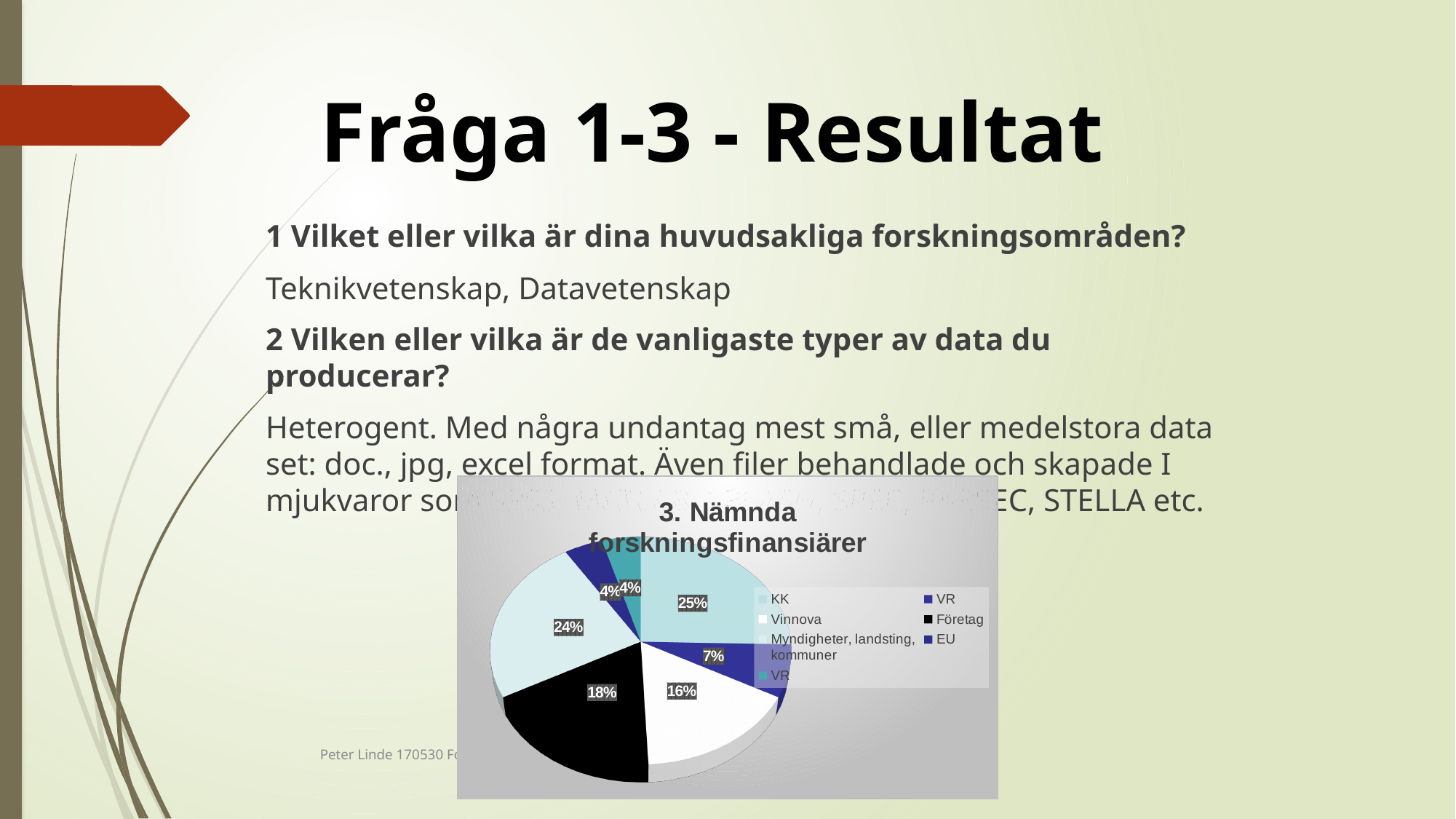
What share of the pie does KK have? 25% What share of the pie does Företag have? 18% What share of the pie does Vinnova have? 16% What is the difference in percentage points between Företag and Vinnova? 2% What share of the pie does EU have? 4% What share of the pie does Myndigheter, landsting, kommuner have? 24% Which is larger, the slice for KK or the slice for Företag? KK Which category has the largest slice of the pie? KK What is the title of the pie chart? 3. Nämnda forskningsfinansiärer What kind of chart is shown on the slide? pie chart How many slices does the pie chart have? 7 How many entries does the legend of the pie chart list? 7